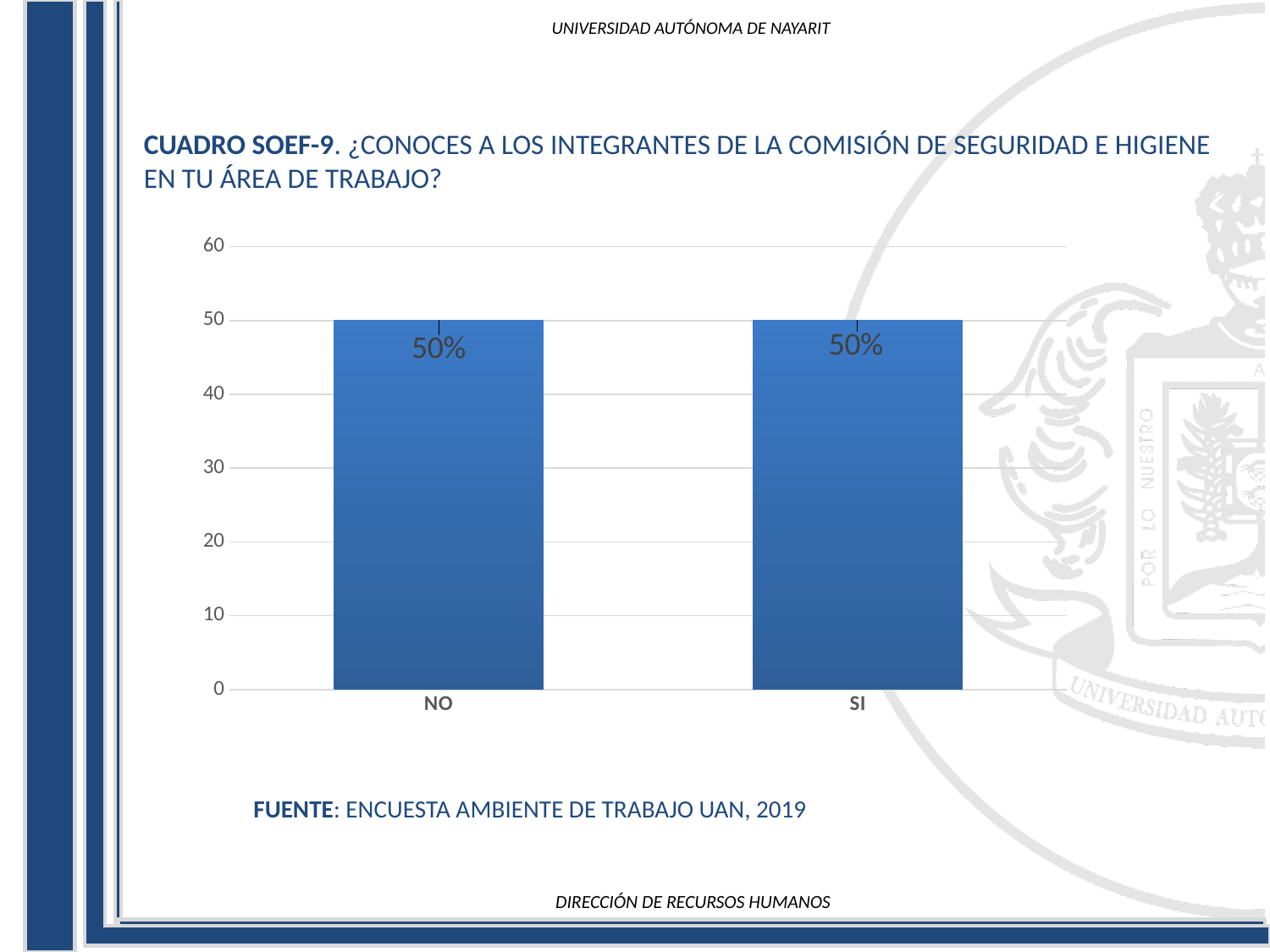
Is the value for NO greater or less than 40? greater What is the value for SI? 50% What is the highest value shown on the y axis? 60 What kind of chart is shown on the slide? bar chart What is the difference between the values for NO and SI? 0 Do the values rise, fall, or stay the same from NO to SI? stay the same What is the value for NO? 50% How many categories are shown on the x axis? 2 Is the value for SI greater or less than 60? less What are the labels of the two categories on the x axis? NO and SI